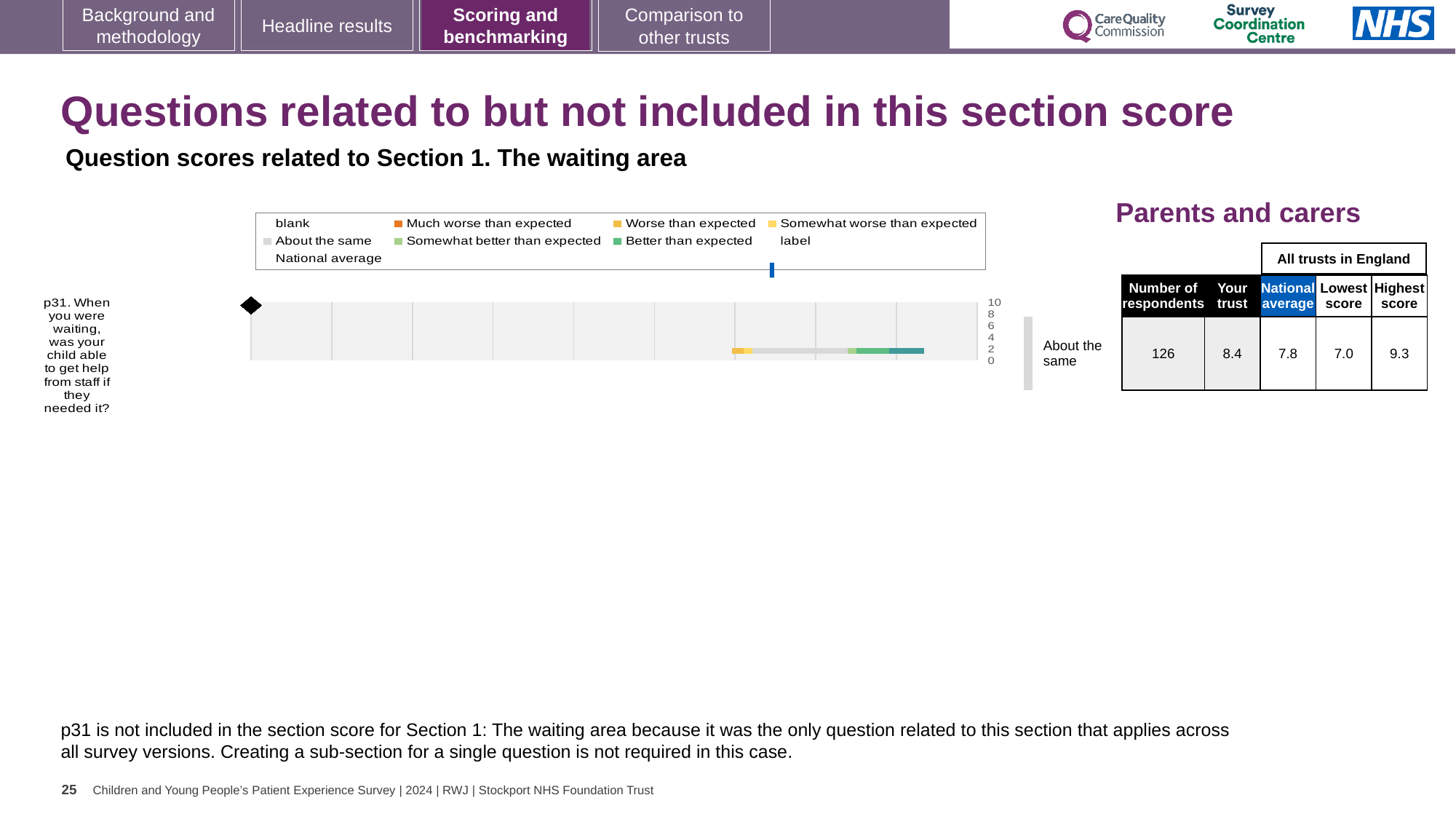
Which question is plotted in the chart? p31. When you were waiting, was your child able to get help from staff if they needed it? What is the trust's score for p31 shown in the Parents and carers table? 8.4 What is the national average score for p31? 7.8 What kind of chart is shown for question p31? bar chart What benchmark category label is shown to the right of the bar for p31? About the same What is the difference between the trust's score and the national average for p31? 0.6 How many survey questions are plotted in the chart? 1 How many respondents answered p31? 126 What is the highest score among all trusts in England for p31? 9.3 What is the difference between the highest and lowest scores for p31 across all trusts in England? 2.3 What is the lowest score among all trusts in England for p31? 7.0 Which is larger for p31, the trust's score or the national average? Your trust